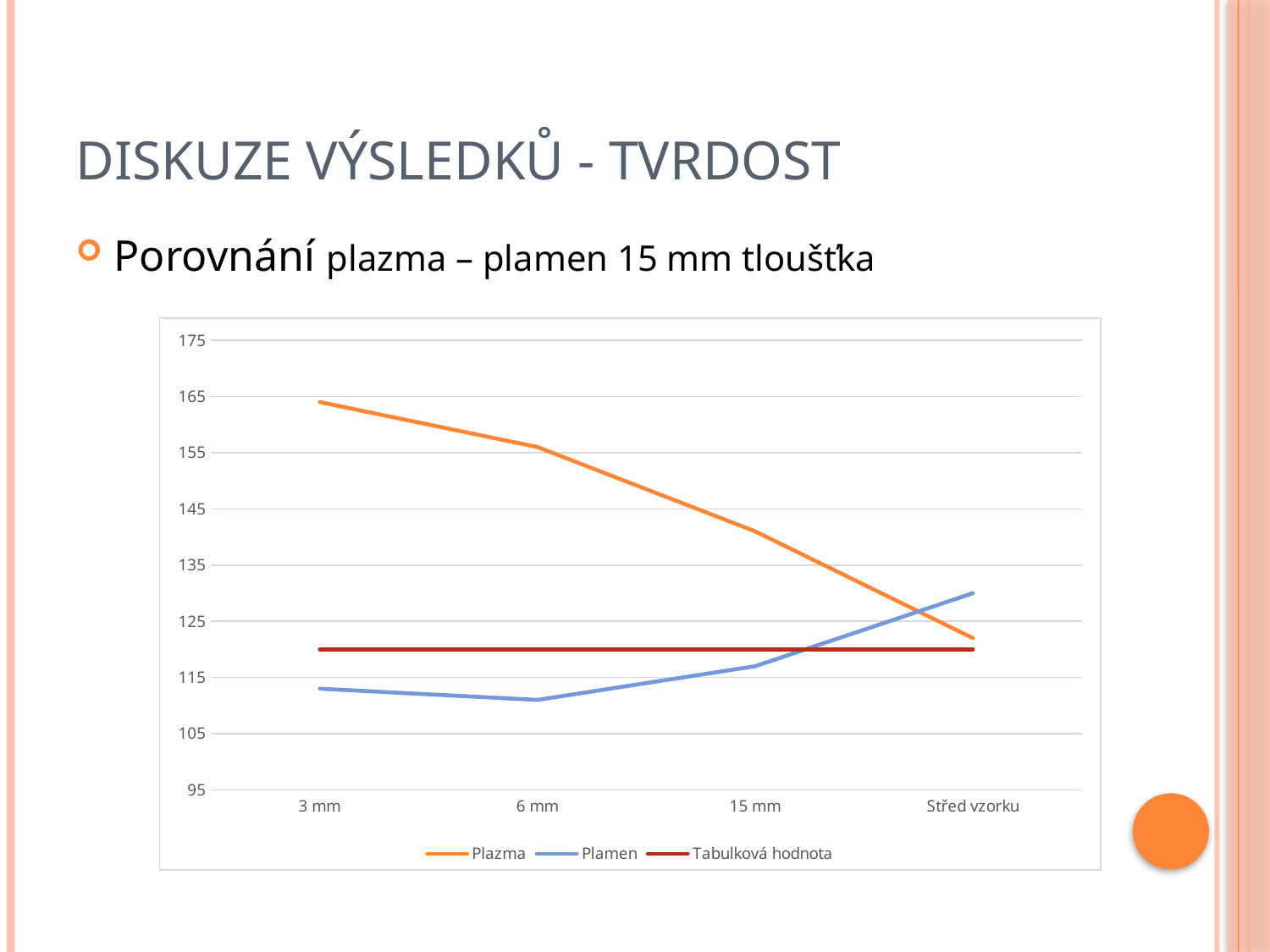
At which category is the Plazma value highest? 3 mm Which series is drawn as a flat horizontal line across all categories? Tabulková hodnota Is the value for Plazma at 3 mm greater or less than 155? greater How many series does the legend list? 3 What kind of chart is shown on the slide? line chart Is the value for Plamen at Střed vzorku greater or less than 125? greater Is the value for Plamen at 3 mm greater or less than 115? less How many categories are shown on the x axis? 4 At which category is the Plazma value lowest? Střed vzorku Do the values for Plazma rise or fall from 3 mm to Střed vzorku? fall At 3 mm, which series has the larger value, Plazma or Plamen? Plazma At which category is the Plamen value highest? Střed vzorku